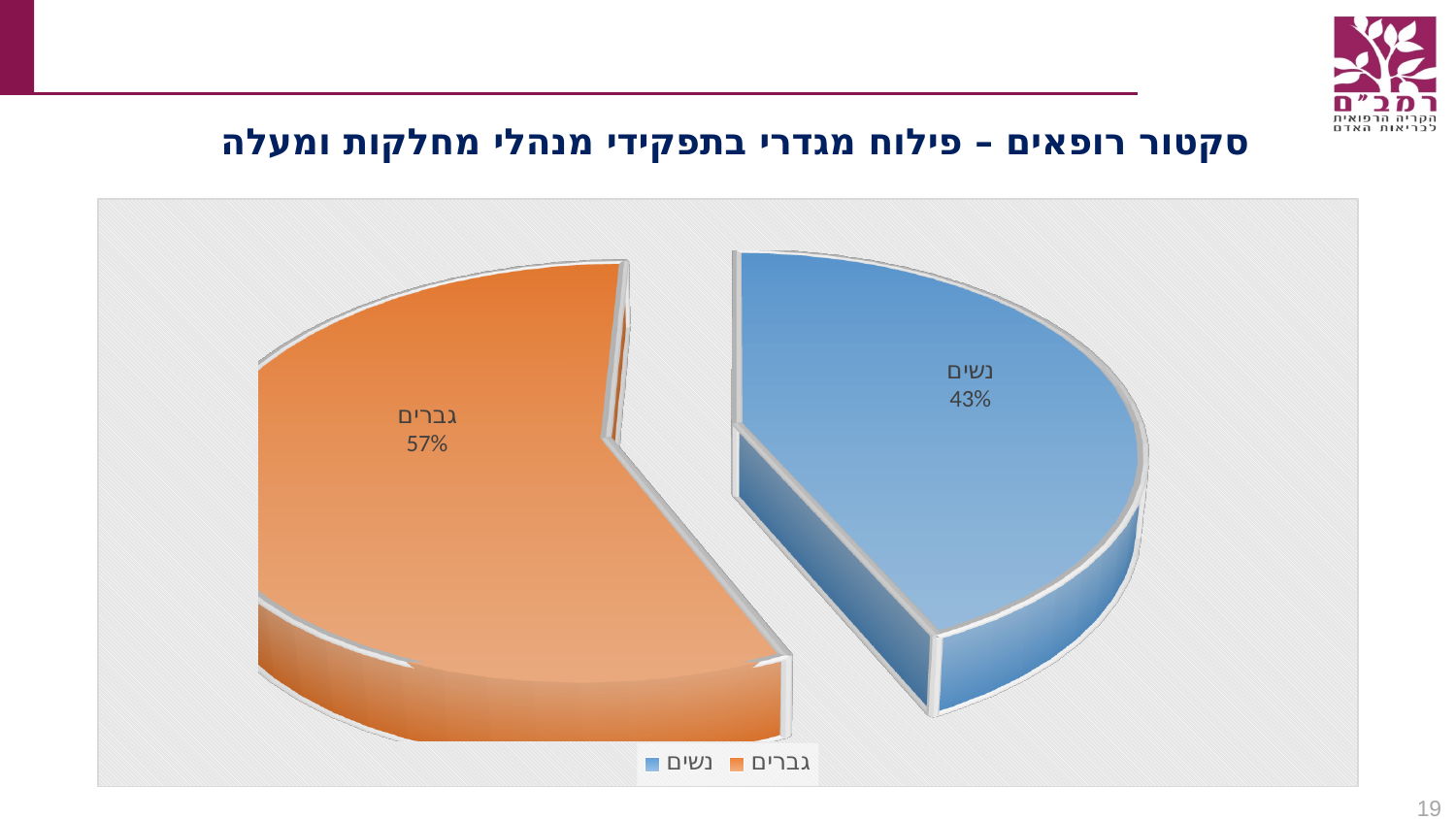
What is the difference in percentage points between the גברים slice and the נשים slice? 14 What is the combined share of the גברים and נשים slices? 100% What kind of chart is shown on the slide? Pie chart What colour is the נשים slice? Blue How many entries does the legend list? 2 Which is larger, the share for גברים or the share for נשים? גברים Which slice of the pie is the smallest? נשים What is the title of the chart on the slide? סקטור רופאים – פילוח מגדרי בתפקידי מנהלי מחלקות ומעלה What share of the pie does גברים represent? 57% What share of the pie does נשים represent? 43% How many slices does the pie chart have? 2 Which slice of the pie is the largest? גברים